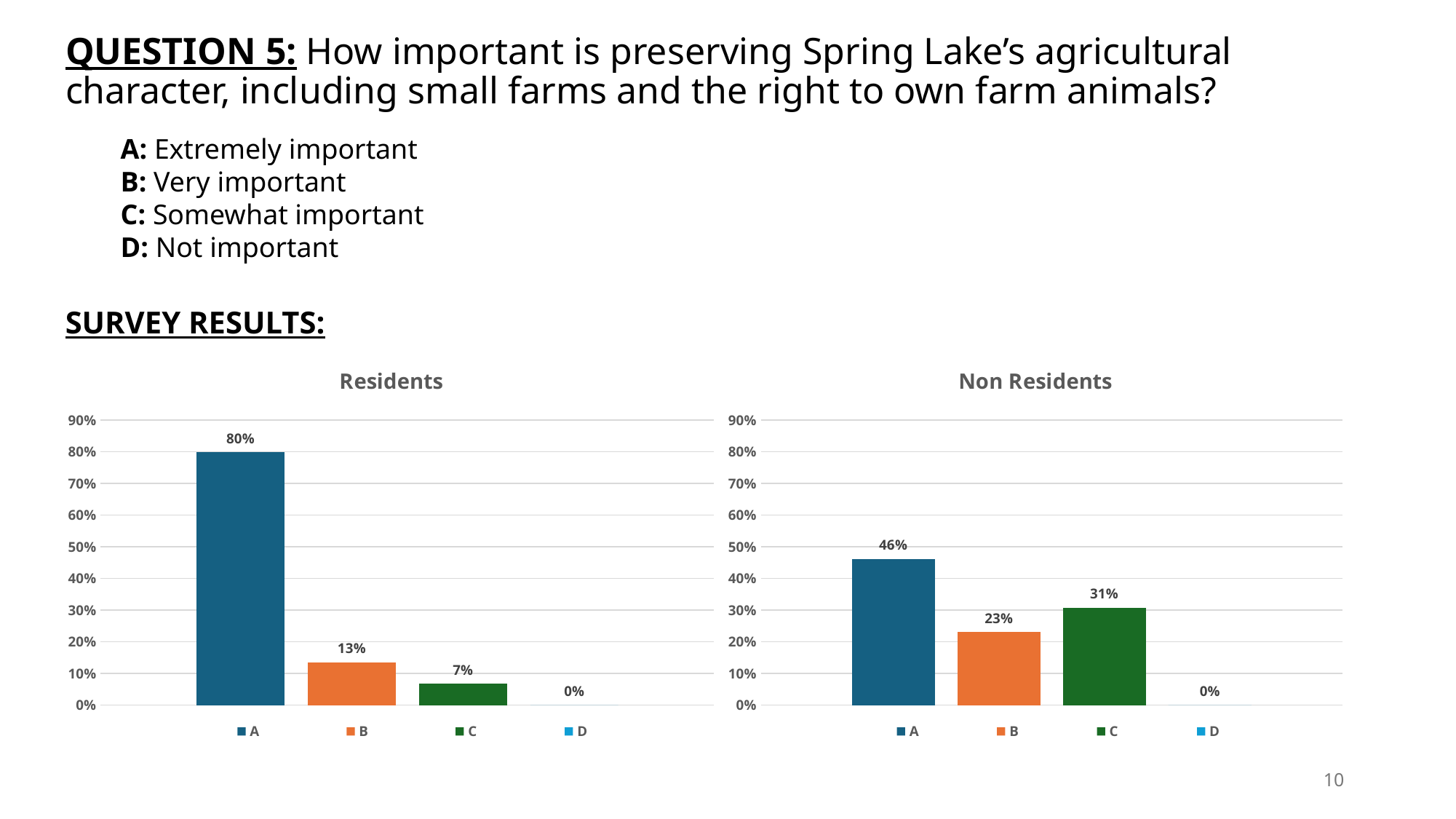
In the Non Residents chart, what is the value for C? 31% In the Non Residents chart, what is the difference between the values for A and C? 15% In the Non Residents chart, what is the value for B? 23% In the Non Residents chart, which category has the lowest value? D In the Residents chart, what is the difference between the values for A and B? 67% In the Non Residents chart, which is larger, the value for B or the value for C? C In the Residents chart, is the value for A greater or less than 70%? greater What kind of chart is the Residents chart? bar chart How many categories are shown in the Non Residents chart? 4 What is the title of the chart on the right side of the slide? Non Residents In the Residents chart, what is the value for A? 80% In the Residents chart, which category has the highest value? A